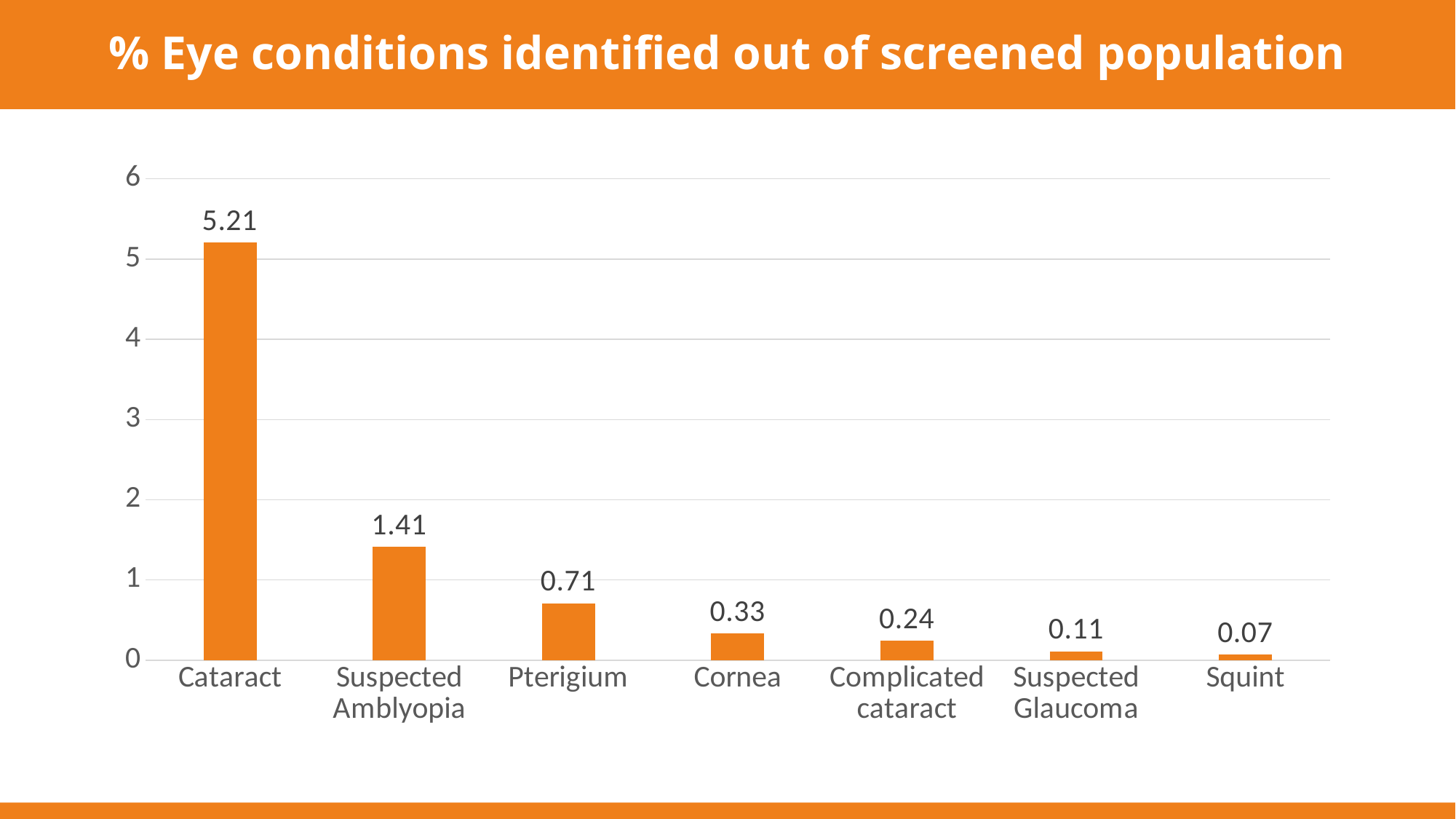
Which eye condition has the highest value? Cataract How many eye conditions are shown on the chart? 7 What is the difference between the values for Cataract and Suspected Amblyopia? 3.80 What is the value for Cataract? 5.21 What is the value for Pterigium? 0.71 What kind of chart is shown on the slide? bar chart What is the value for Complicated cataract? 0.24 Is the value for Pterigium greater or less than 1? less What is the value for Suspected Amblyopia? 1.41 Which eye condition has the lowest value? Squint What is the title of the chart? % Eye conditions identified out of screened population Which is larger, the value for Cornea or the value for Suspected Glaucoma? Cornea